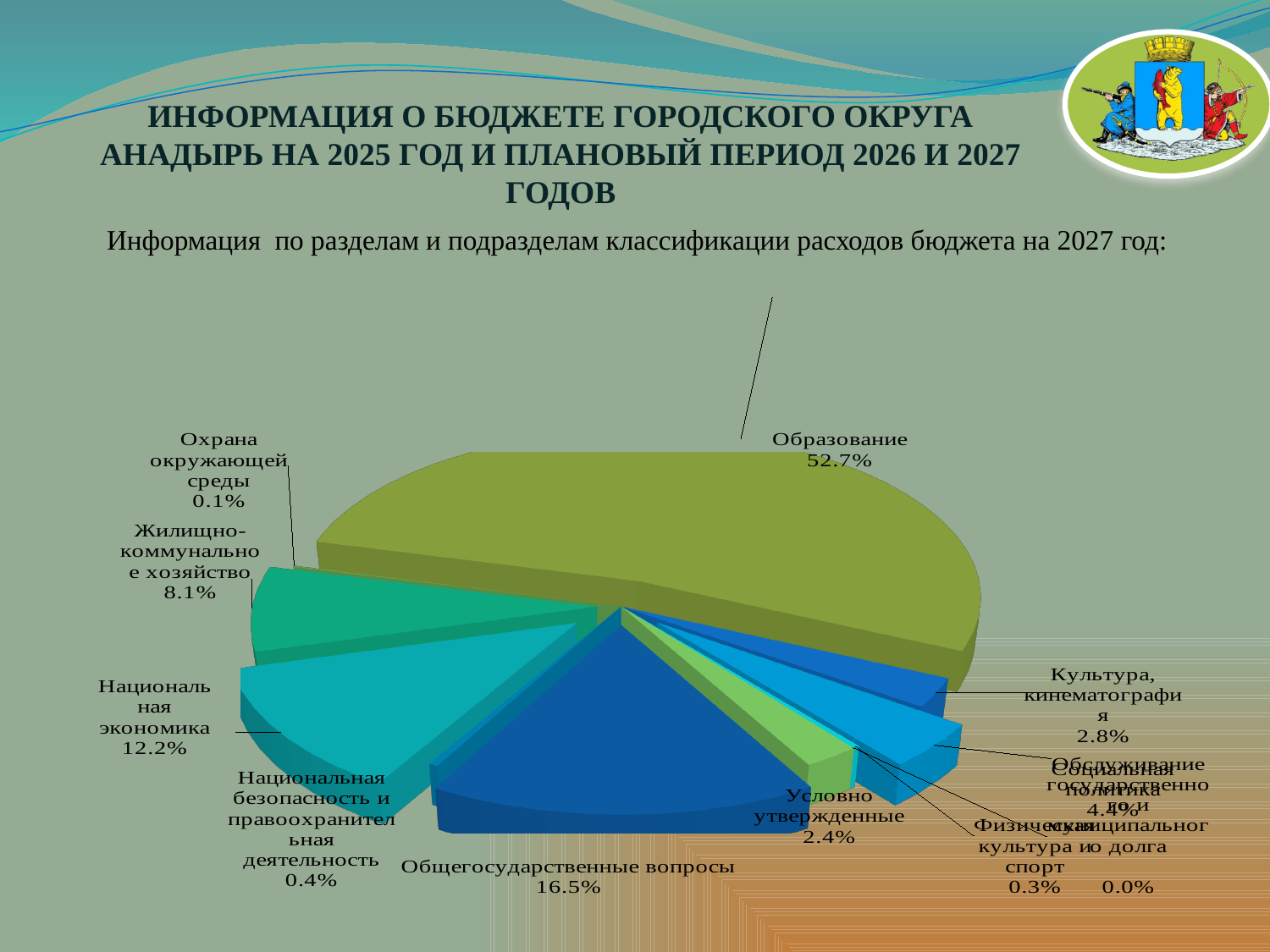
What kind of chart is shown on the slide? pie chart For which year does the chart show the breakdown of budget expenditures by section? 2027 What share of the 2027 budget expenditures goes to Образование? 52.7% Which category has the largest share of the pie? Образование What percentage is shown for Общегосударственные вопросы? 16.5% What percentage is shown for Национальная экономика? 12.2% Which is larger: the share for Национальная экономика or for Жилищно-коммунальное хозяйство? Национальная экономика What percentage is shown for Условно утвержденные? 2.4% What is the difference in percentage points between Национальная экономика and Жилищно-коммунальное хозяйство? 4.1% What percentage is shown for Культура, кинематография? 2.8% What percentage is shown for Жилищно-коммунальное хозяйство? 8.1% What is the difference in percentage points between Образование and Общегосударственные вопросы? 36.2%